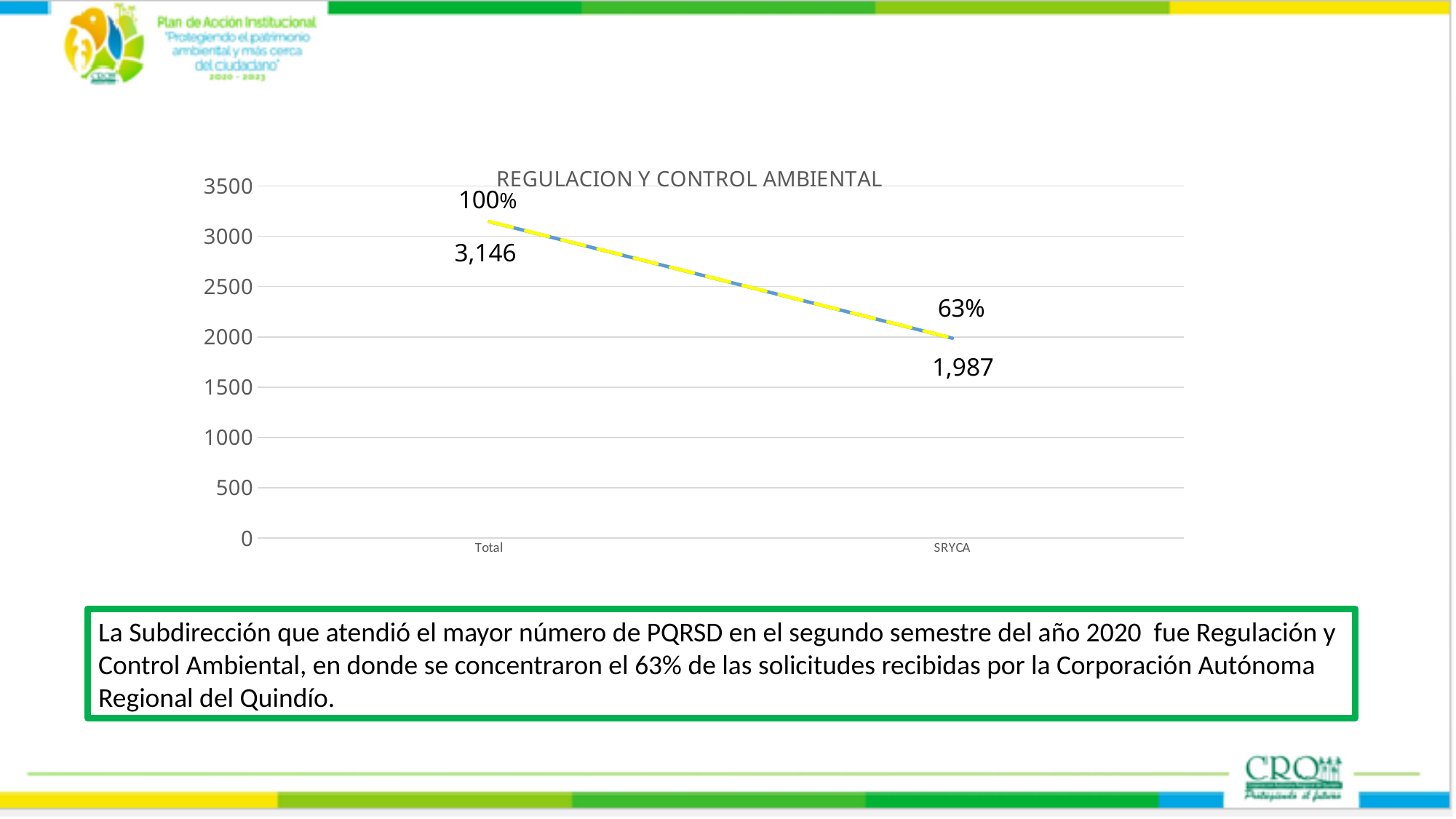
What is the difference between the Total value and the SRYCA value? 1,159 What is the value for SRYCA? 1,987 What kind of chart is shown? line chart Is the value for Total greater or less than 3000? greater Which category has the lowest value? SRYCA What percentage is shown for SRYCA? 63% What percentage is shown for Total? 100% Is the value for SRYCA greater or less than 2000? less What is the title of the chart? REGULACION Y CONTROL AMBIENTAL What is the value for Total? 3,146 Which category has the higher value, Total or SRYCA? Total How many categories are shown on the x axis? 2